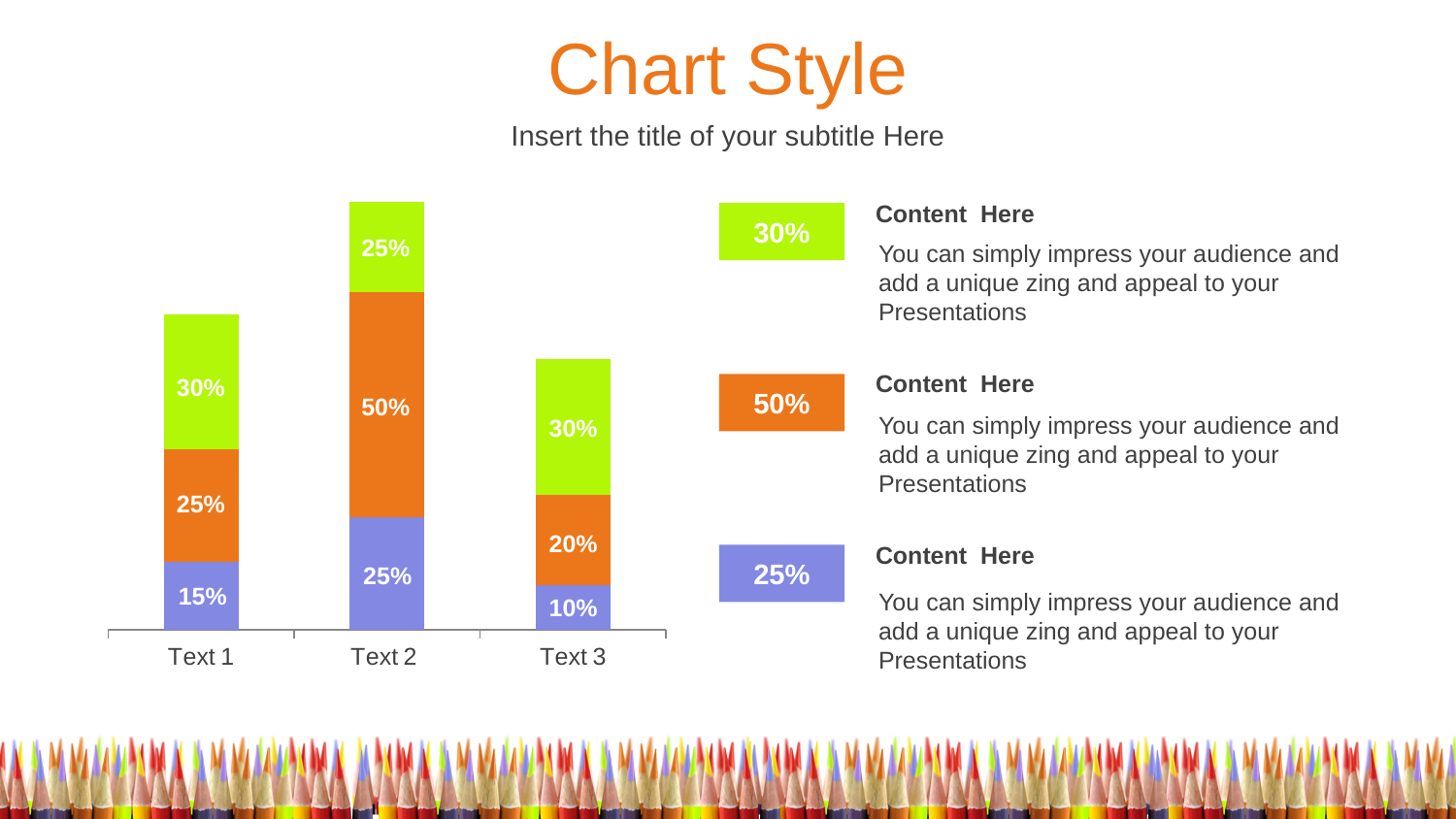
What is the difference between the orange segment of Text 2 and the orange segment of Text 1? 25% Which is larger, the purple segment for Text 2 or the purple segment for Text 3? Text 2 What is the value of the green (top) segment for Text 3? 30% What is the total of the stacked bar for Text 3? 60% What is the value of the orange (middle) segment for Text 2? 50% What is the value of the purple (bottom) segment for Text 1? 15% What kind of chart is shown on the slide? Stacked bar chart What is the total of the stacked bar for Text 2? 100% How many categories are shown on the x axis of the chart? 3 Which category has the shortest stacked bar? Text 3 What is the total of the stacked bar for Text 1? 70% Which category has the tallest stacked bar? Text 2